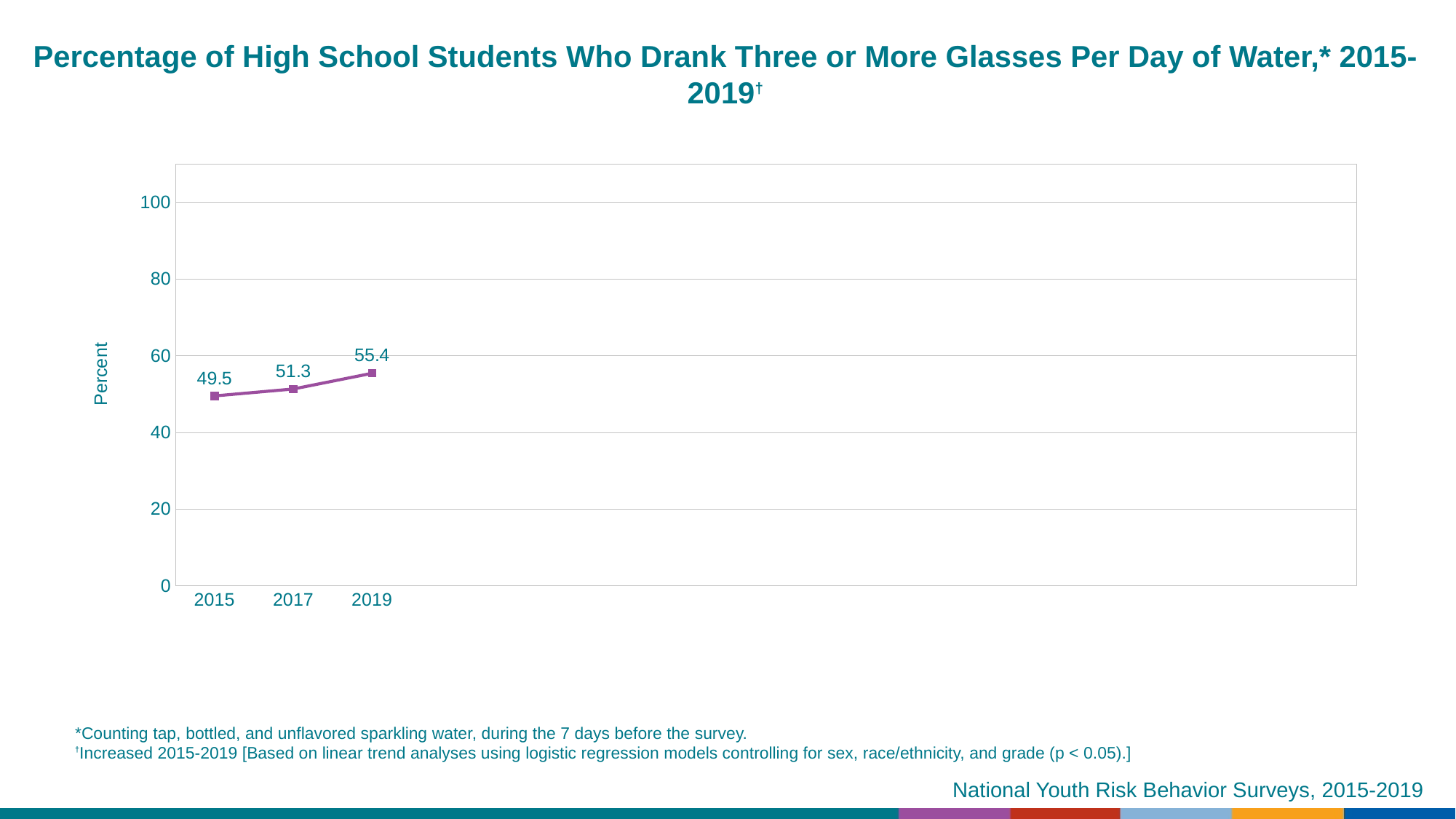
What percentage of high school students drank three or more glasses of water per day in 2019? 55.4 How many years are plotted on the chart? 3 What percentage of high school students drank three or more glasses of water per day in 2015? 49.5 What is the difference between the 2019 and 2015 percentages? 5.9 Do the values rise or fall from 2015 to 2019? rise Is the value for 2015 greater or less than 60? less What kind of chart is shown on the slide? line chart Which year has the lowest percentage of students who drank three or more glasses of water per day? 2015 What percentage of high school students drank three or more glasses of water per day in 2017? 51.3 Which year has the highest percentage of students who drank three or more glasses of water per day? 2019 Which year has a larger value, 2017 or 2019? 2019 What is the difference between the 2017 and 2015 percentages? 1.8